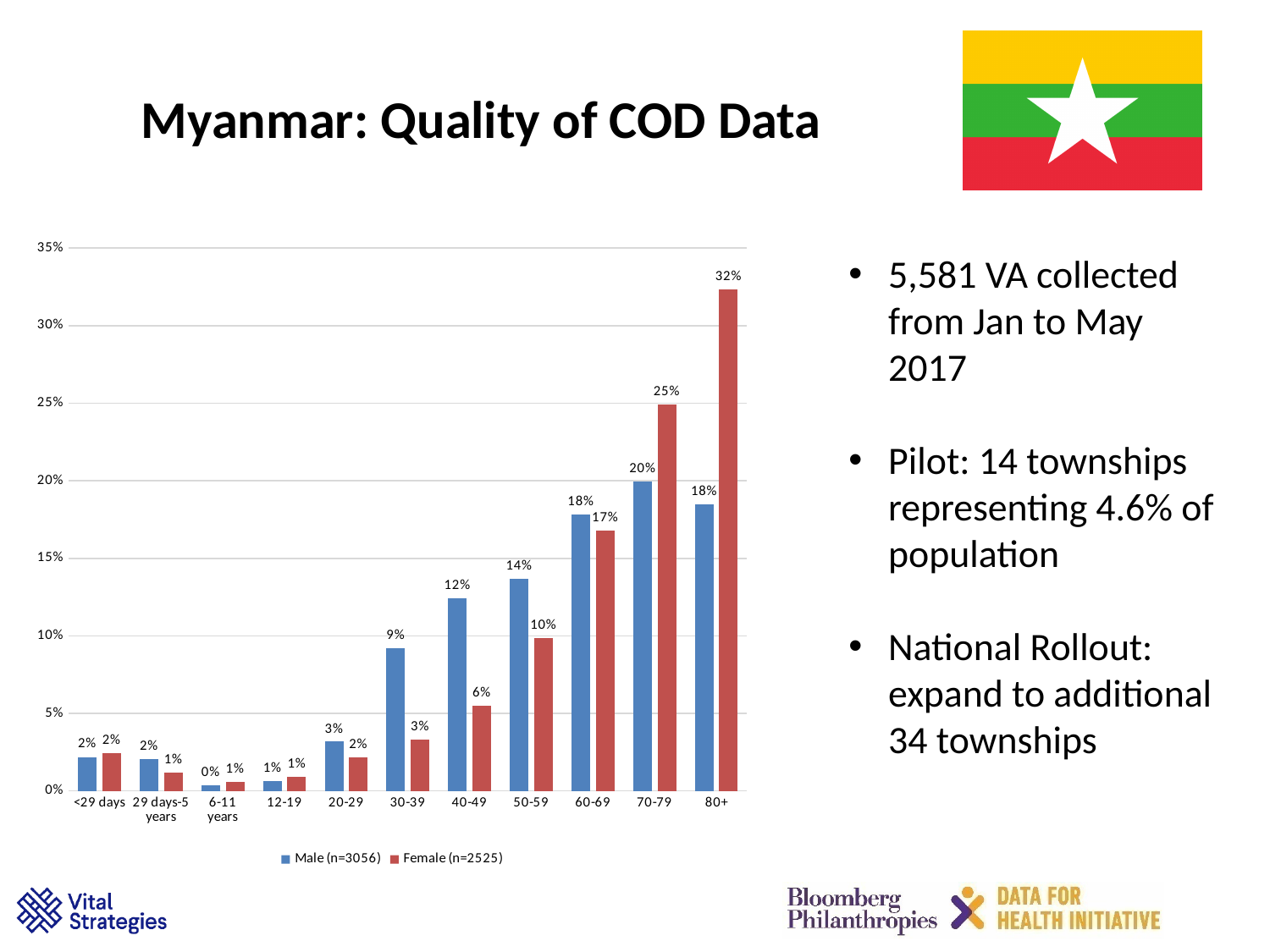
Which age group has the lowest Male value? 6-11 years What is the sample size (n) for the Male series shown in the legend? 3056 Is the Female value for the 70-79 age group greater or less than 20%? greater What is the Male value for the 70-79 age group? 20% What kind of chart is shown on the slide? bar chart For the 50-59 age group, which is larger, the Male or the Female value? Male What is the difference between the Female and Male values for the 80+ age group? 14% Which age group has the highest Female value? 80+ What is the Female value for the 80+ age group? 32% How many series does the legend list? 2 How many age groups are shown on the x axis? 11 What is the Male value for the 40-49 age group? 12%